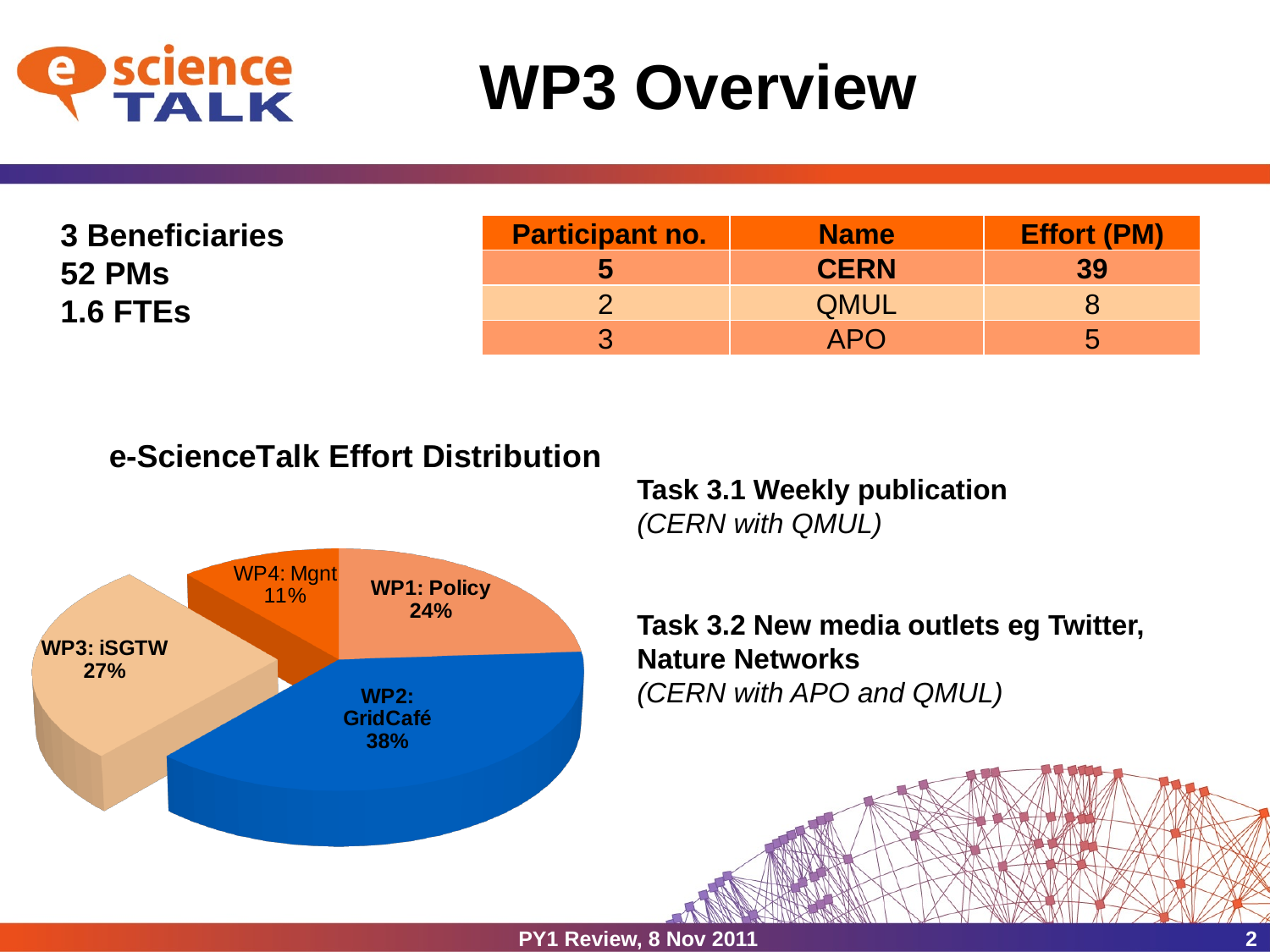
Which work package has the largest slice in the e-ScienceTalk Effort Distribution chart? WP2: GridCafé In the e-ScienceTalk Effort Distribution chart, what is the difference in percentage points between WP2: GridCafé and WP3: iSGTW? 11 In the e-ScienceTalk Effort Distribution chart, what is the combined share of WP1: Policy and WP4: Mgnt? 35% Which work package has the smallest slice in the e-ScienceTalk Effort Distribution chart? WP4: Mgnt What kind of chart is the e-ScienceTalk Effort Distribution chart? pie chart What share of effort does WP2: GridCafé have in the e-ScienceTalk Effort Distribution chart? 38% What is the title of the pie chart on the slide? e-ScienceTalk Effort Distribution What share of effort does WP1: Policy have in the e-ScienceTalk Effort Distribution chart? 24% What share of effort does WP4: Mgnt have in the e-ScienceTalk Effort Distribution chart? 11% How many slices does the e-ScienceTalk Effort Distribution pie chart have? 4 In the e-ScienceTalk Effort Distribution chart, which has a larger share, WP1: Policy or WP3: iSGTW? WP3: iSGTW What share of effort does WP3: iSGTW have in the e-ScienceTalk Effort Distribution chart? 27%